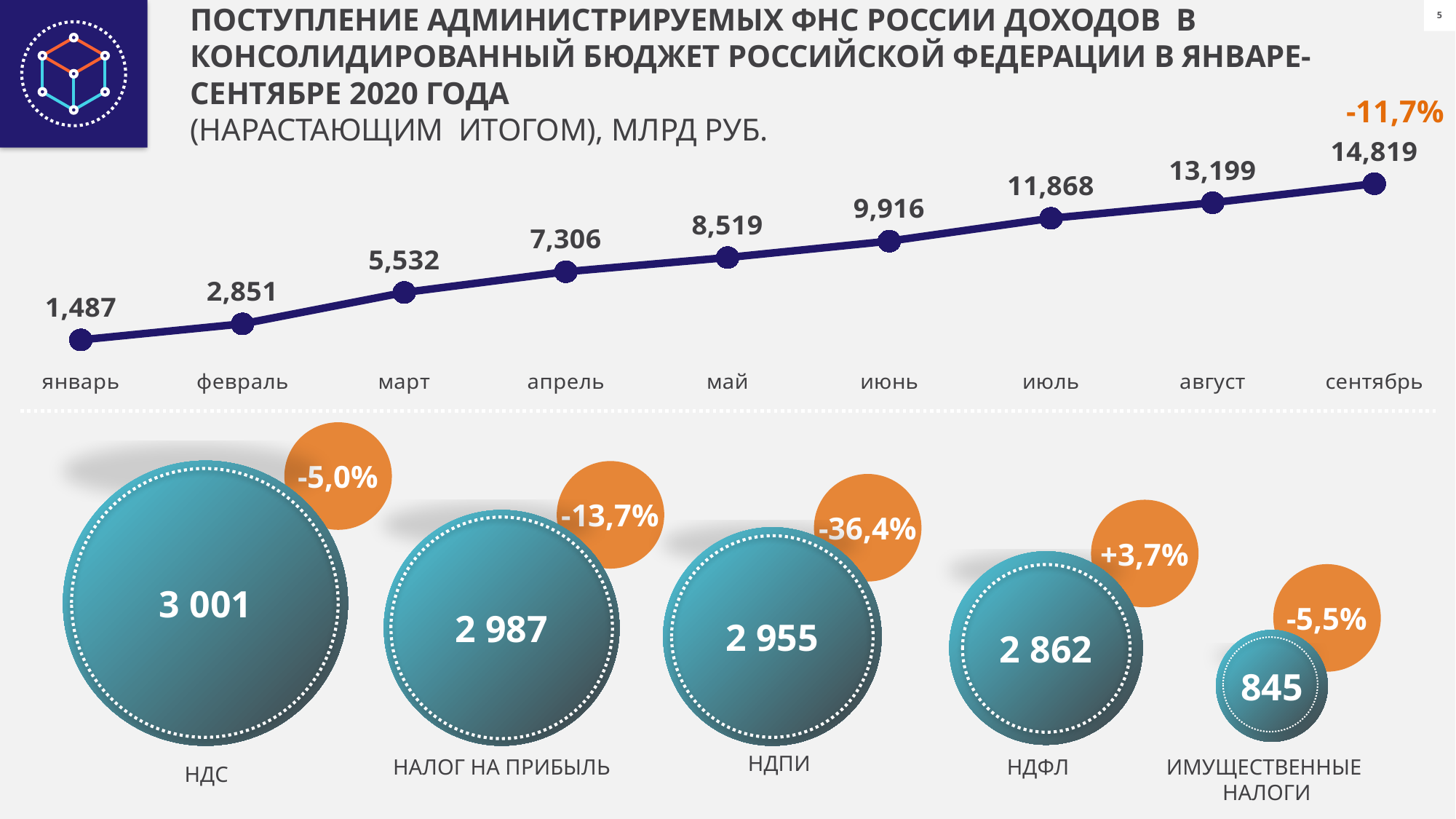
On the line chart at the top of the slide, what is the value for март? 5,532 On the line chart at the top of the slide, what is the value for сентябрь? 14,819 On the line chart at the top of the slide, do the values rise or fall from январь to сентябрь? rise On the line chart at the top of the slide, how many months are plotted? 9 On the line chart at the top of the slide, what is the difference between the values for сентябрь and август? 1,620 On the line chart at the top of the slide, what is the value for июнь? 9,916 In the circle chart at the bottom of the slide, what is the value shown for НДПИ? 2 955 On the line chart at the top of the slide, what is the difference between the values for март and февраль? 2,681 On the line chart at the top of the slide, which month has the highest value? сентябрь On the line chart at the top of the slide, which month has the lowest value? январь In the circle chart at the bottom of the slide, which category has the smallest value? ИМУЩЕСТВЕННЫЕ НАЛОГИ What kind of chart is shown at the top of the slide? line chart